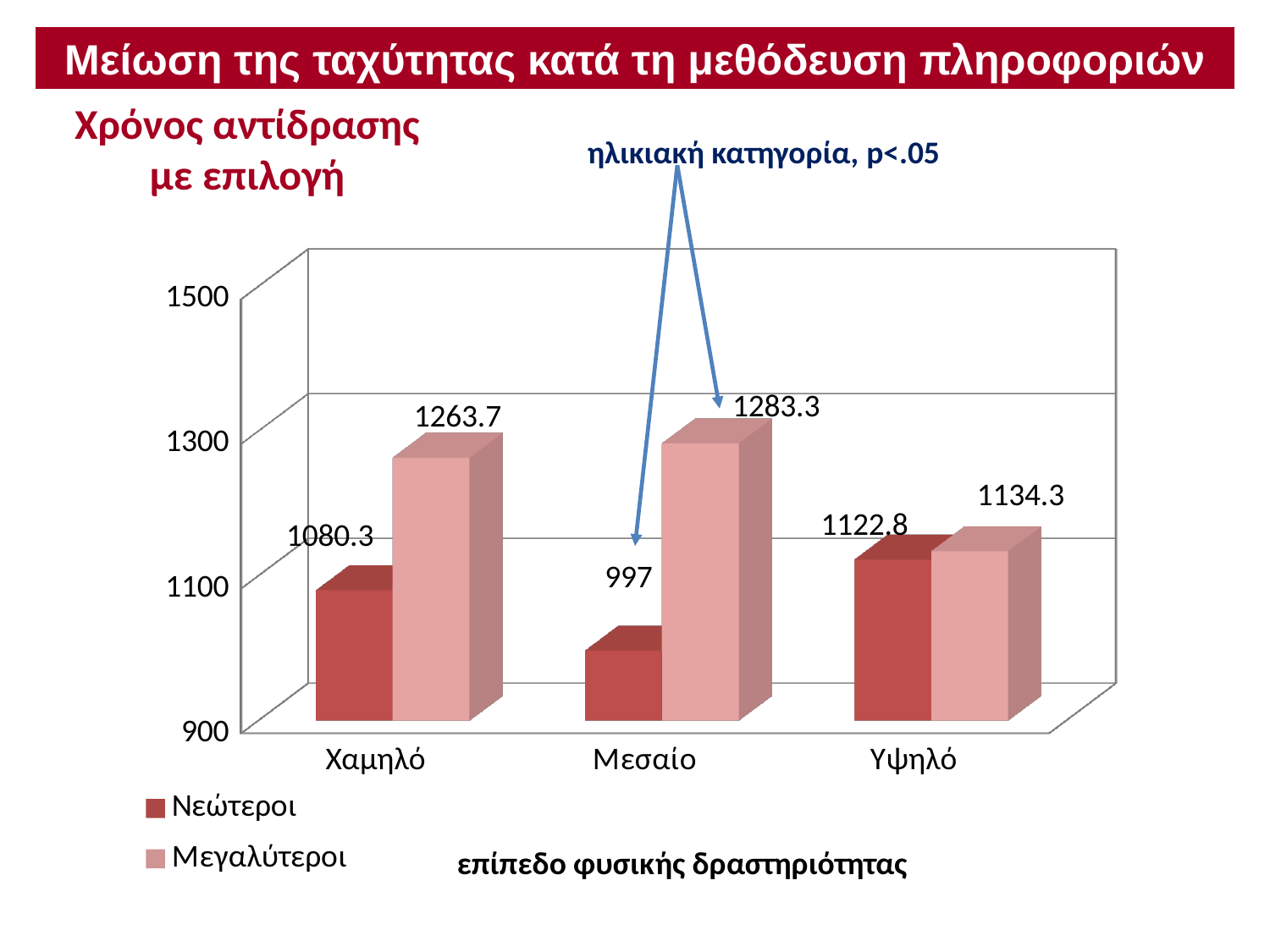
What is the value for Νεώτεροι in the Υψηλό category? 1122.8 Which is larger: the Νεώτεροι value for Χαμηλό or the Νεώτεροι value for Υψηλό? Υψηλό How many categories are shown on the x axis? 3 What kind of chart is shown on the slide? Bar chart What is the x-axis label of the chart? επίπεδο φυσικής δραστηριότητας What is the value for Μεγαλύτεροι in the Μεσαίο category? 1283.3 Which category has the highest value for Μεγαλύτεροι? Μεσαίο Which category has the lowest value for Νεώτεροι? Μεσαίο What is the difference between the Μεγαλύτεροι and Νεώτεροι values in the Μεσαίο category? 286.3 How many series does the legend list? 2 What is the difference between the Μεγαλύτεροι values for Χαμηλό and Υψηλό? 129.4 What is the value for Νεώτεροι in the Χαμηλό category? 1080.3